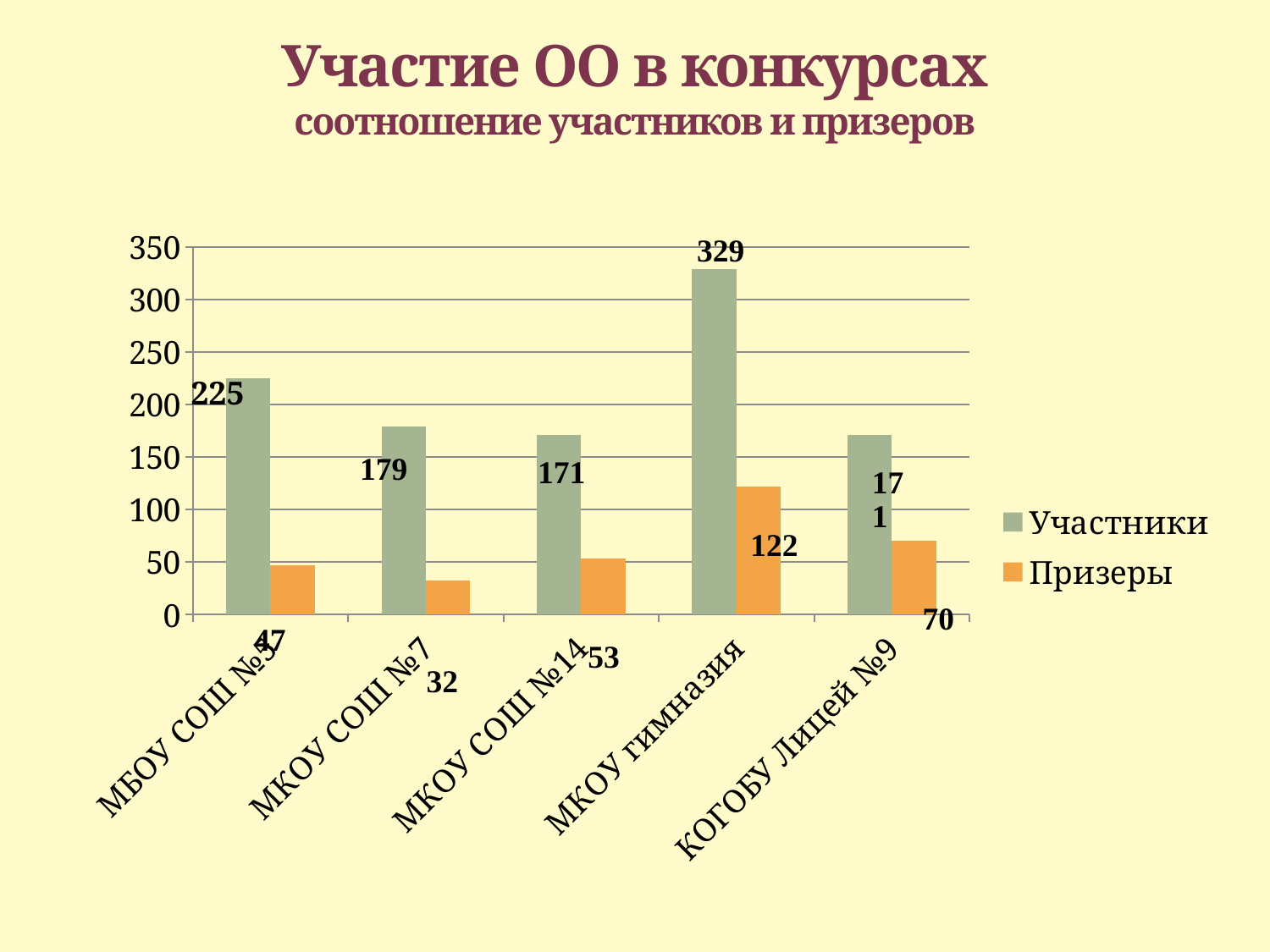
What is the value of Призеры for КОГОБУ Лицей №9? 70 What is the difference between Участники and Призеры for МКОУ гимназия? 207 What is the value of Призеры for МКОУ СОШ №14? 53 How many participants (Участники) does МКОУ гимназия have? 329 Which category has the highest number of Участники? МКОУ гимназия What is the value of Участники for МКОУ СОШ №7? 179 Which category has the lowest number of Призеры? МКОУ СОШ №7 How many series does the legend list? 2 Which has more Призеры: МКОУ СОШ №14 or КОГОБУ Лицей №9? КОГОБУ Лицей №9 How many categories (schools) are shown on the x axis? 5 What is the number of prize winners (Призеры) for МКОУ СОШ №7? 32 What kind of chart is shown on the slide? Bar chart